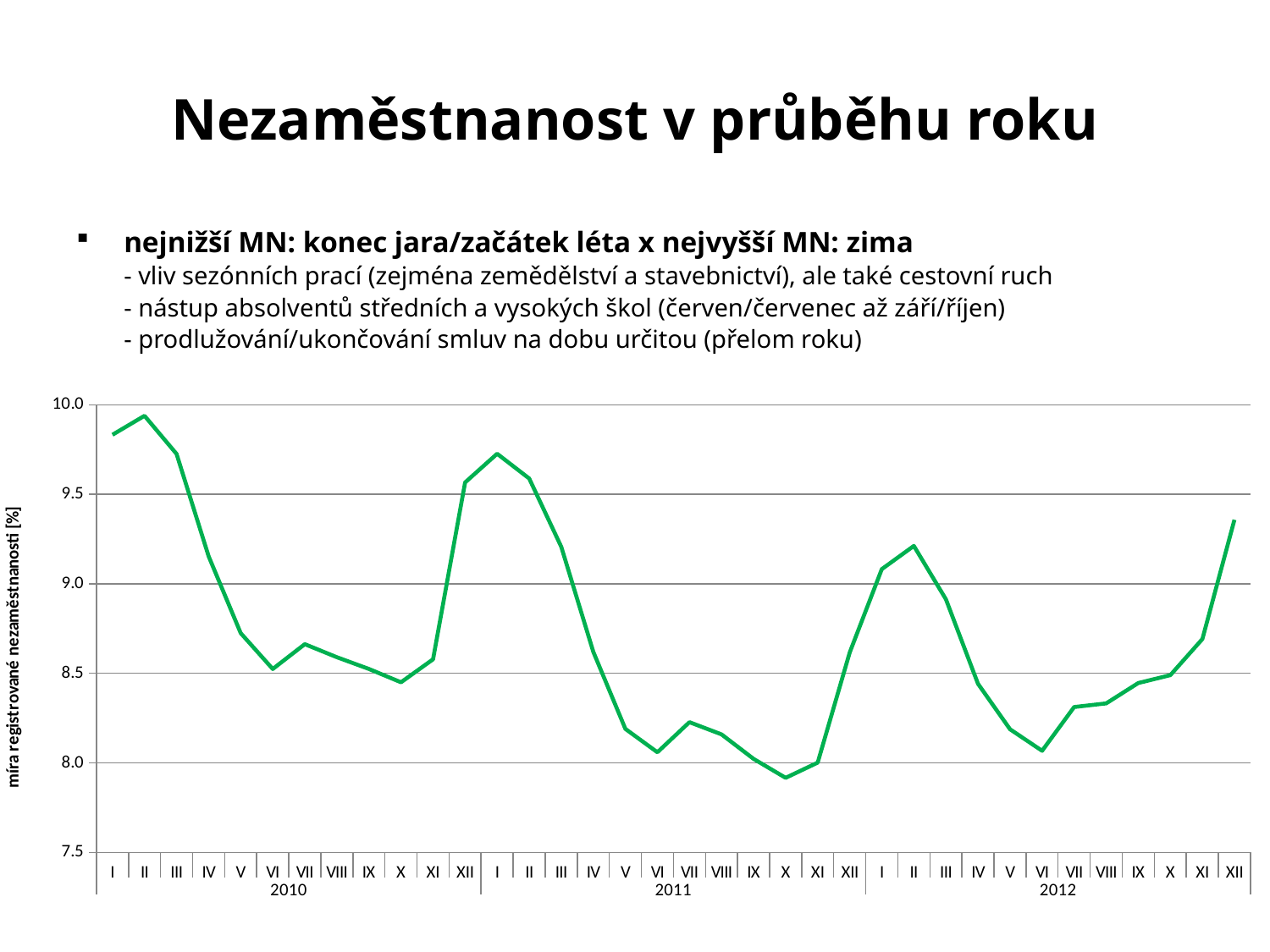
How many monthly data points are plotted on the chart? 36 What kind of chart is shown on the slide? line chart How many years are shown on the x axis of the chart? 3 Is the value for I 2010 greater or less than 9.5? greater Is the value for VI 2012 greater or less than 8.5? less In which month and year does the line reach its lowest value? X 2011 Is the value for I 2011 greater or less than 9.5? greater Which is larger, the value for II 2011 or the value for II 2012? II 2011 What is the label of the vertical axis? míra registrované nezaměstnanosti [%] Does the line rise or fall from II 2010 to VI 2010? fall In which month and year does the line reach its highest value? II 2010